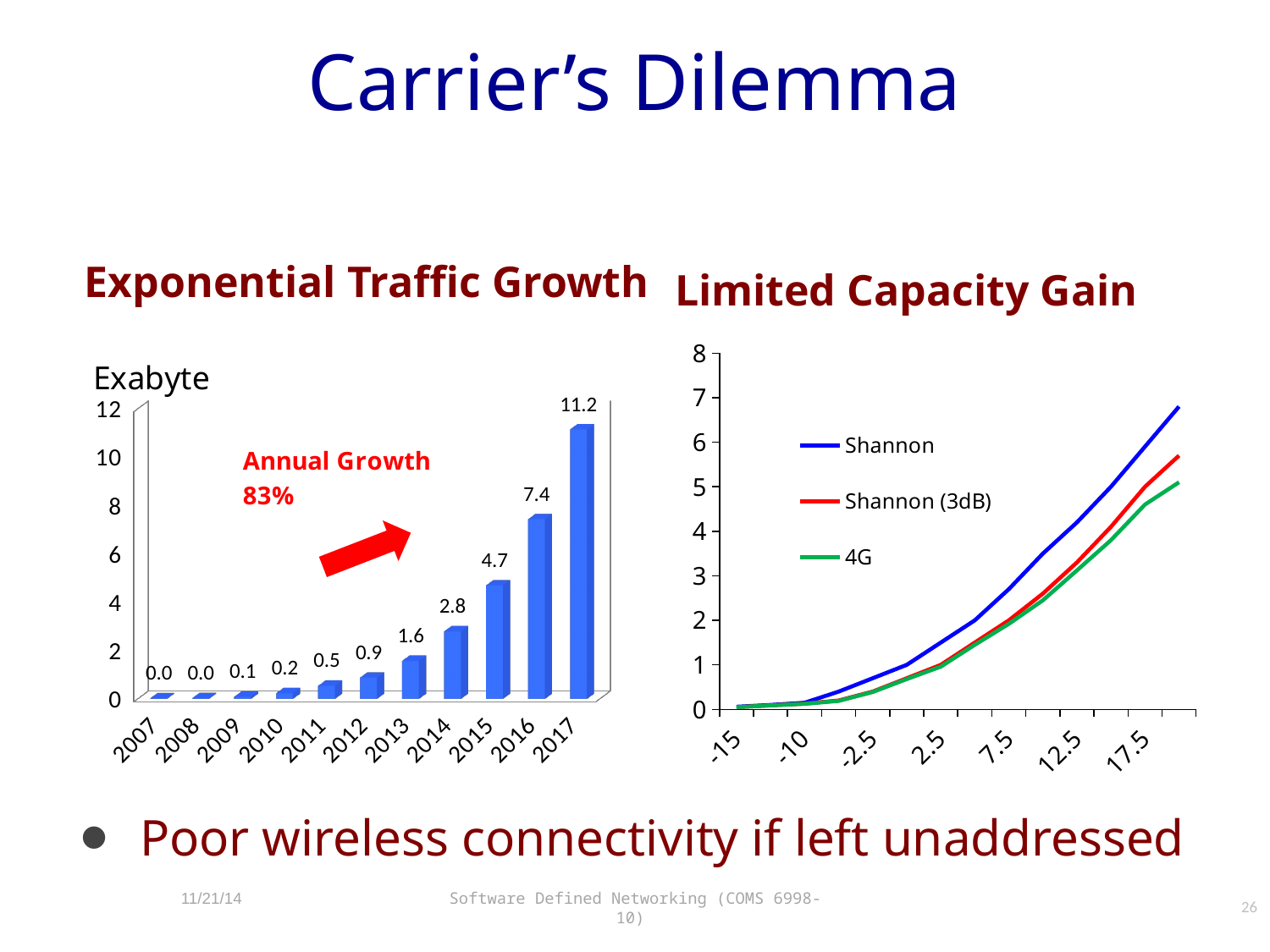
In the Limited Capacity Gain chart, which series is drawn in blue? Shannon In the Exponential Traffic Growth chart, what is the value for 2017? 11.2 In the Exponential Traffic Growth chart, do the values rise or fall from 2007 to 2017? rise In the Exponential Traffic Growth chart, what is the difference between the values for 2017 and 2016? 3.8 What kind of chart is the Exponential Traffic Growth chart? bar chart In the Exponential Traffic Growth chart, what annual growth rate is stated on the chart? 83% In the Exponential Traffic Growth chart, what is the value for 2014? 2.8 In the Exponential Traffic Growth chart, how many years are shown on the x axis? 11 How many series does the legend of the Limited Capacity Gain chart list? 3 In the Limited Capacity Gain chart, is the value of the Shannon series at 17.5 greater or less than 4? greater In the Exponential Traffic Growth chart, which is larger, the value for 2015 or the value for 2013? 2015 In the Exponential Traffic Growth chart, which year has the highest value? 2017